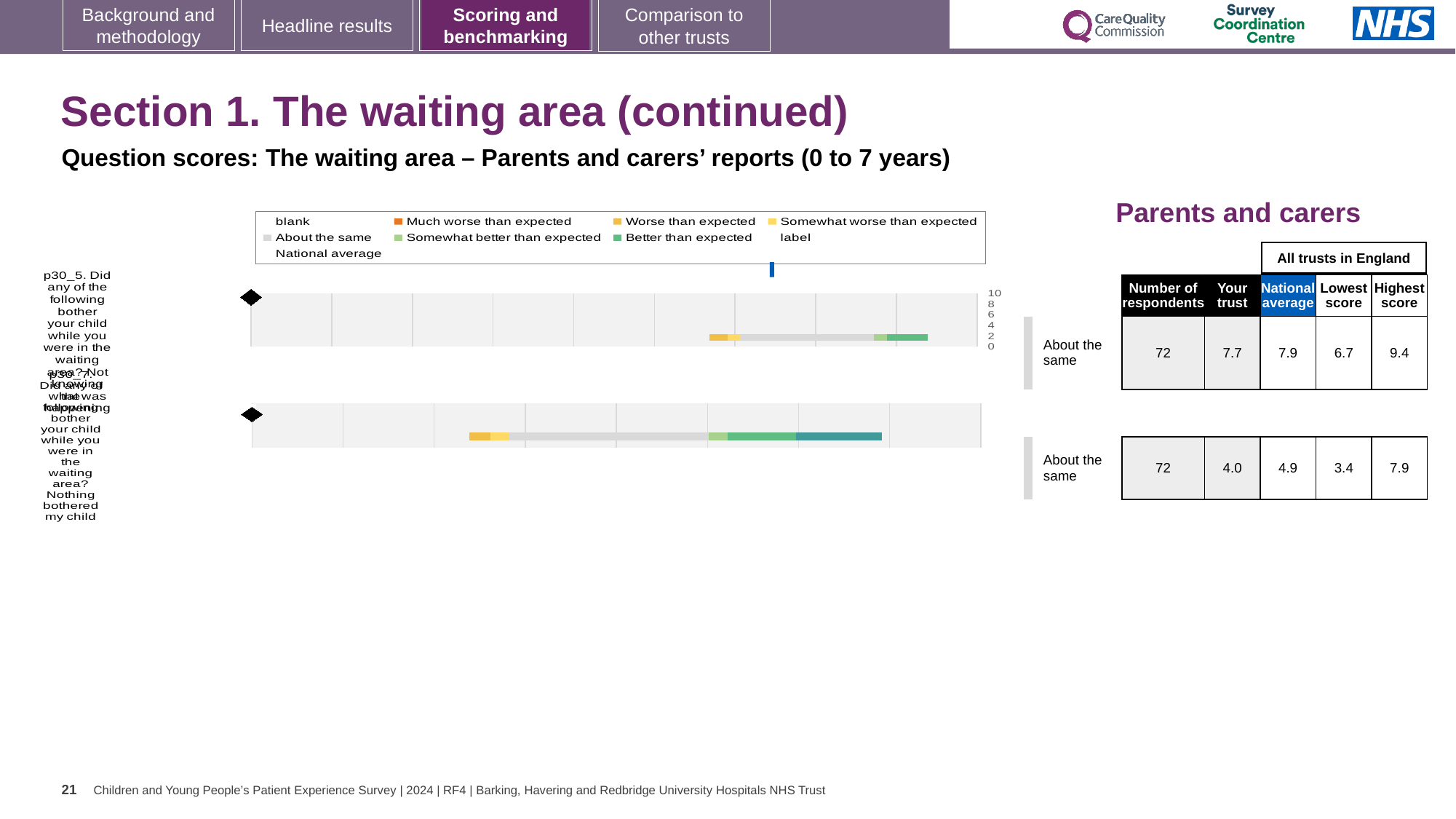
How many respondents are listed for the top question row? 72 How many bars (question rows) does the chart show? 2 In the table for the bottom question row, what is the 'Your trust' score? 4.0 For the top question row, which is larger: the 'Your trust' score or the national average? National average For the bottom question row, what is the difference between the national average (4.9) and the 'Your trust' score (4.0)? 0.9 What benchmark category label is shown next to both bars on the chart? About the same In the table for the bottom question row, what is the highest score among all trusts in England? 7.9 How many entries does the chart legend list? 9 For the top question row, what is the difference between the highest score (9.4) and the lowest score (6.7)? 2.7 In the table for the top question row, what is the 'Your trust' score? 7.7 In the table for the top question row, what is the national average score? 7.9 What kind of chart is shown on the slide? bar chart